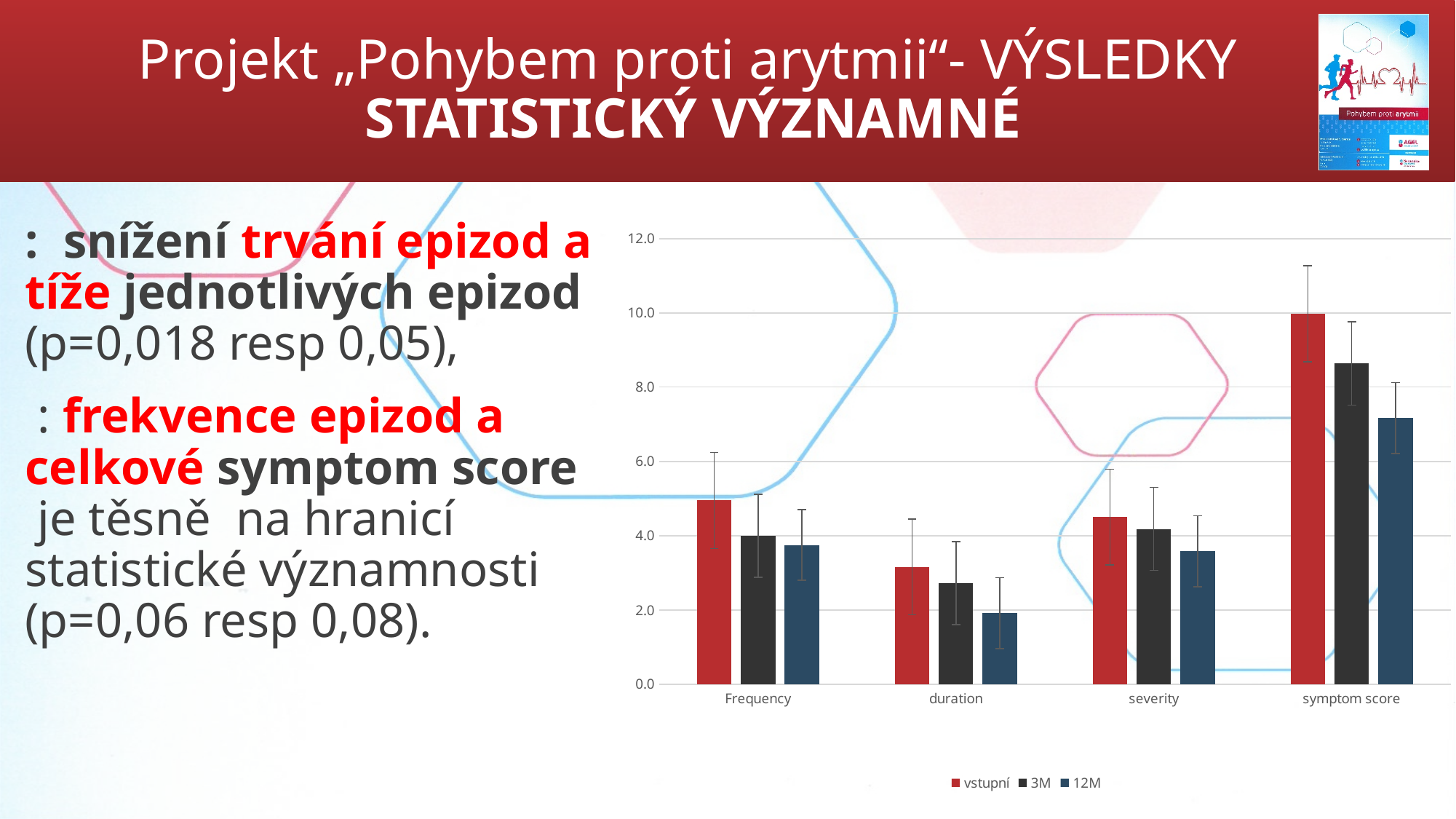
Which category has the highest value for the 'vstupní' series? symptom score How many categories are shown on the x axis of the chart? 4 How many series does the chart's legend list? 3 For 'symptom score', which is larger: the 'vstupní' value or the '3M' value? vstupní Which colour represents the 'vstupní' series in the chart? red What are the series names listed in the chart's legend? vstupní, 3M, 12M Is the 'vstupní' value for 'Frequency' greater or less than 4.0? greater Is the 'vstupní' value for 'symptom score' greater or less than 8.0? greater Is the '12M' value for 'duration' greater or less than 4.0? less Within each category, do the bars rise or fall going from 'vstupní' to '3M' to '12M'? fall What kind of chart is shown on the slide? bar chart Which category has the lowest value for the '12M' series? duration